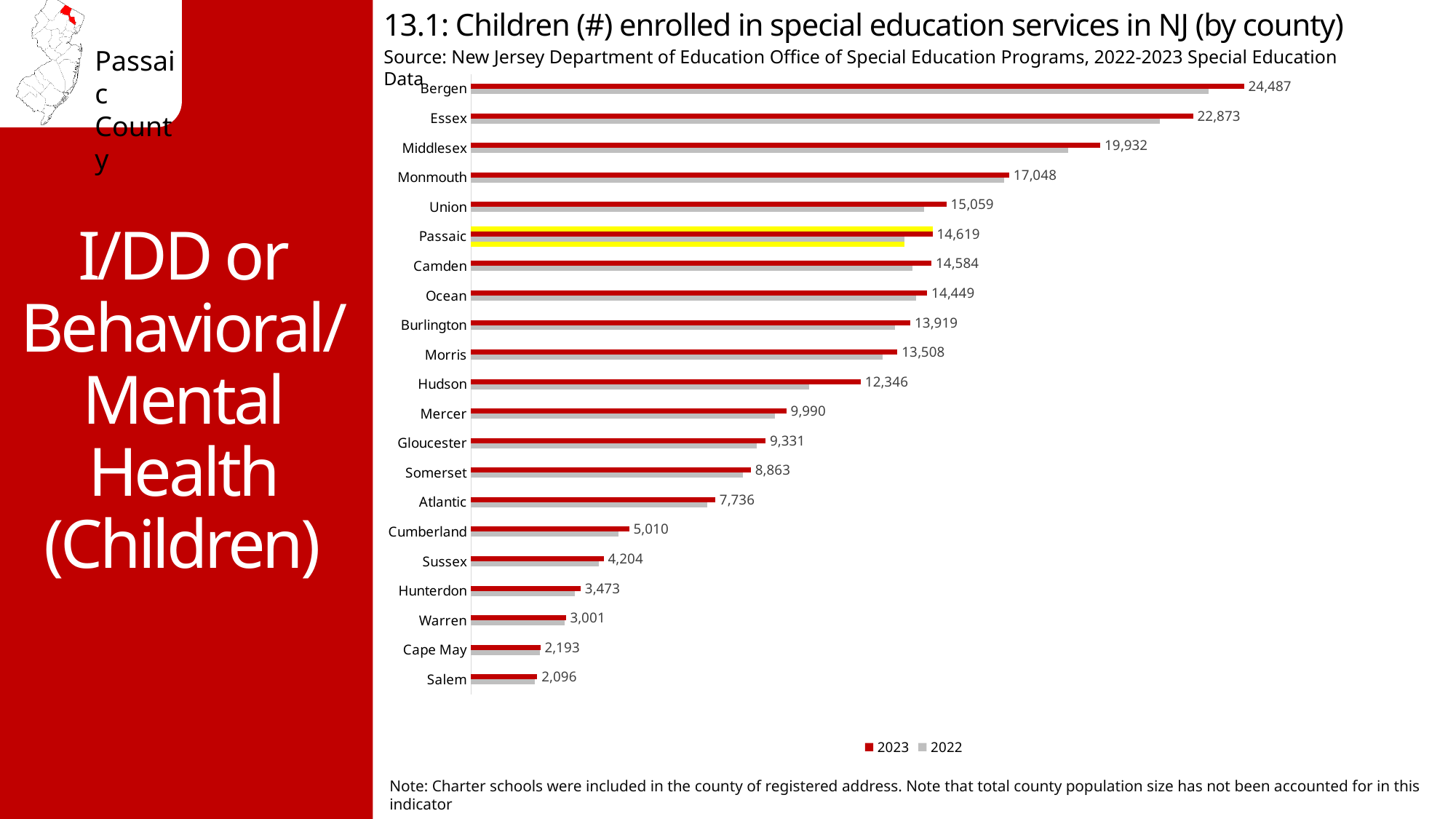
What is the 2023 value for Salem? 2,096 What is the 2023 value for Passaic? 14,619 Which has the larger 2023 value, Hudson or Mercer? Hudson What kind of chart is shown on the slide? Bar chart Which county's bars are highlighted in yellow? Passaic How many series does the legend list? 2 What is the difference between the 2023 values for Passaic and Camden? 35 What is the difference between the 2023 values for Bergen and Essex? 1,614 What is the 2023 value for Bergen? 24,487 How many counties are shown in the chart? 21 Which county has the highest 2023 value? Bergen Which county has the lowest 2023 value? Salem